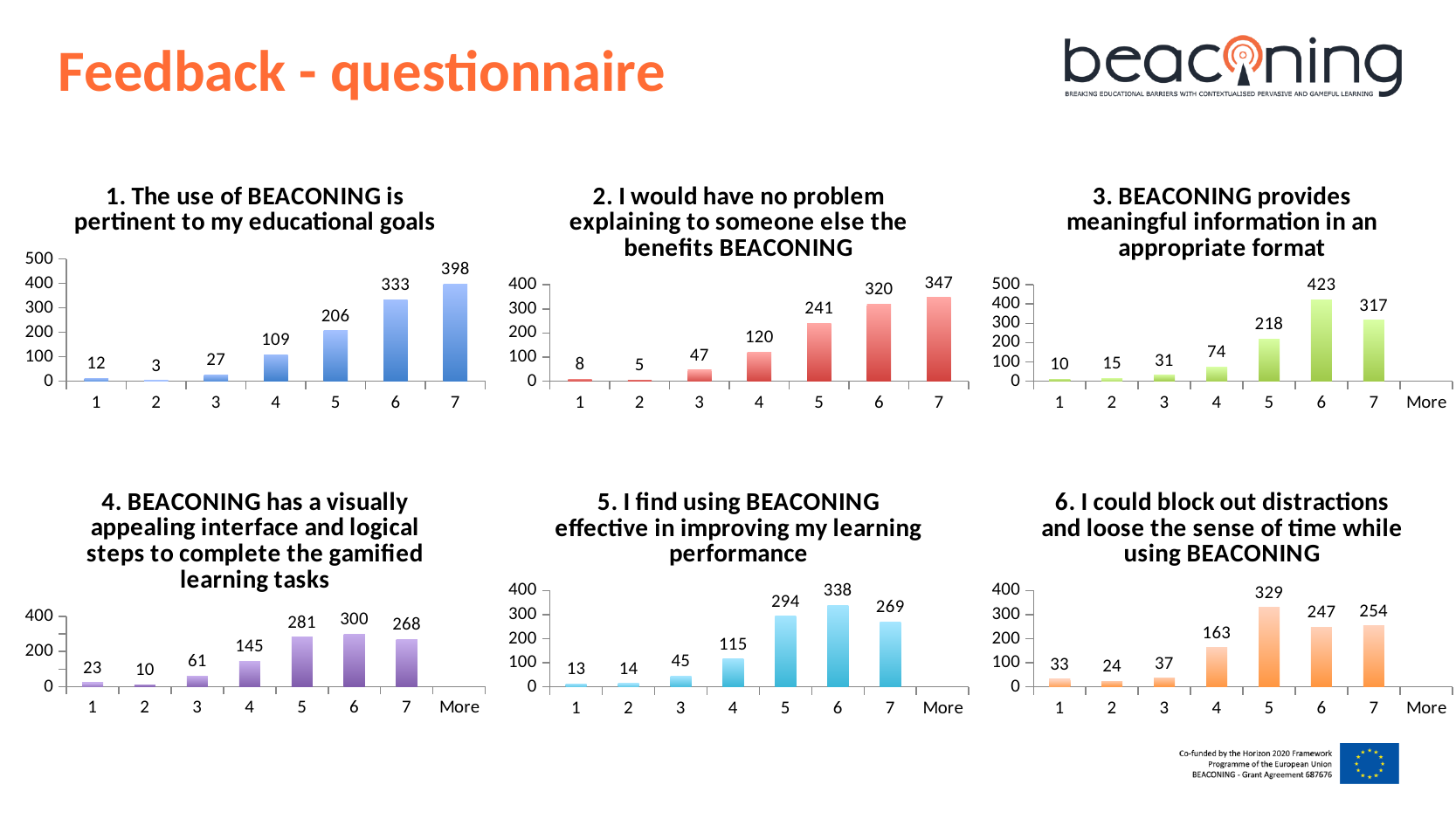
In the chart titled "2. I would have no problem explaining to someone else the benefits BEACONING", what is the value for category 5? 241 In the chart titled "1. The use of BEACONING is pertinent to my educational goals", what is the value for category 7? 398 In the chart titled "6. I could block out distractions and loose the sense of time while using BEACONING", which category has the highest value? 5 In the chart titled "6. I could block out distractions and loose the sense of time while using BEACONING", what is the difference between the values for categories 7 and 6? 7 In the chart titled "4. BEACONING has a visually appealing interface and logical steps to complete the gamified learning tasks", what is the value for category 6? 300 In the chart titled "1. The use of BEACONING is pertinent to my educational goals", which category has the lowest value? 2 What kind of chart is the chart titled "5. I find using BEACONING effective in improving my learning performance"? bar chart In the chart titled "2. I would have no problem explaining to someone else the benefits BEACONING", what is the difference between the values for categories 7 and 6? 27 In the chart titled "5. I find using BEACONING effective in improving my learning performance", what is the value for category 6? 338 In the chart titled "4. BEACONING has a visually appealing interface and logical steps to complete the gamified learning tasks", which is larger, the value for category 5 or category 7? 5 In the chart titled "3. BEACONING provides meaningful information in an appropriate format", which category has the highest value? 6 In the chart titled "3. BEACONING provides meaningful information in an appropriate format", what is the value for category 4? 74